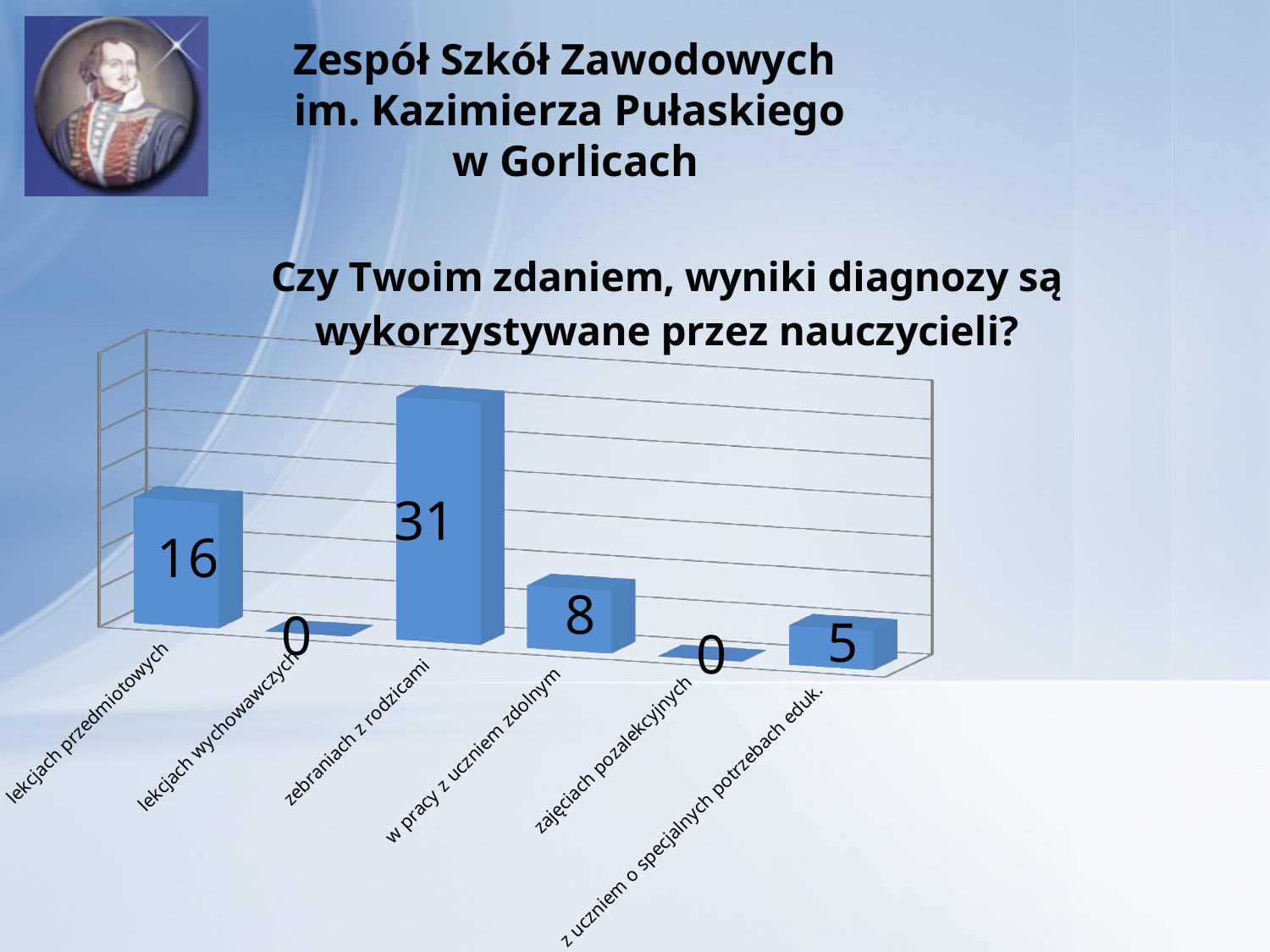
Which category has the highest value? zebraniach z rodzicami What is the value for "lekcjach przedmiotowych"? 16 What is the value for "zebraniach z rodzicami"? 31 What is the difference between the values for "w pracy z uczniem zdolnym" and "z uczniem o specjalnych potrzebach eduk."? 3 What is the value for "lekcjach wychowawczych"? 0 How many categories are shown in the chart? 6 What is the difference between the values for "zebraniach z rodzicami" and "lekcjach przedmiotowych"? 15 Which is larger, the value for "lekcjach przedmiotowych" or the value for "w pracy z uczniem zdolnym"? lekcjach przedmiotowych What is the value for "w pracy z uczniem zdolnym"? 8 What is the value for "z uczniem o specjalnych potrzebach eduk."? 5 What kind of chart is shown on the slide? bar chart What is the title of the chart? Czy Twoim zdaniem, wyniki diagnozy są wykorzystywane przez nauczycieli?